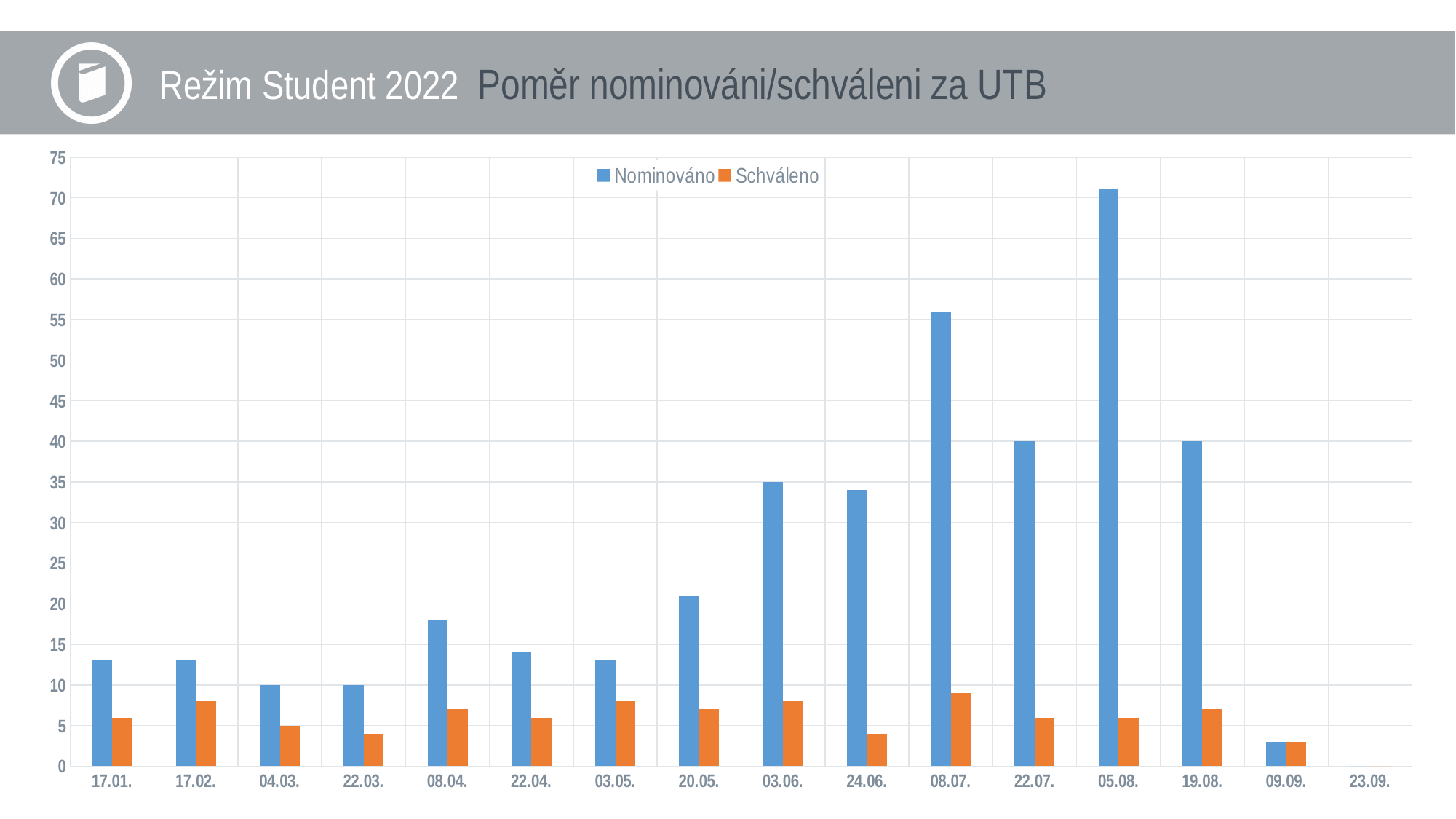
How many dates are shown on the x axis? 16 How many series does the legend list? 2 What is the Nominováno value for 04.03.? 10 What is the Schváleno value for 04.03.? 5 On which date is the Nominováno value highest? 05.08. What are the two series named in the legend? Nominováno and Schváleno What kind of chart is shown on the slide? bar chart What is the Nominováno value for 22.07.? 40 Is the Nominováno value for 05.08. greater or less than 65? greater Which has the larger Nominováno value, 08.07. or 22.07.? 08.07. Is the Nominováno value for 08.07. greater or less than 50? greater What is the difference between the Nominováno values for 22.07. and 04.03.? 30